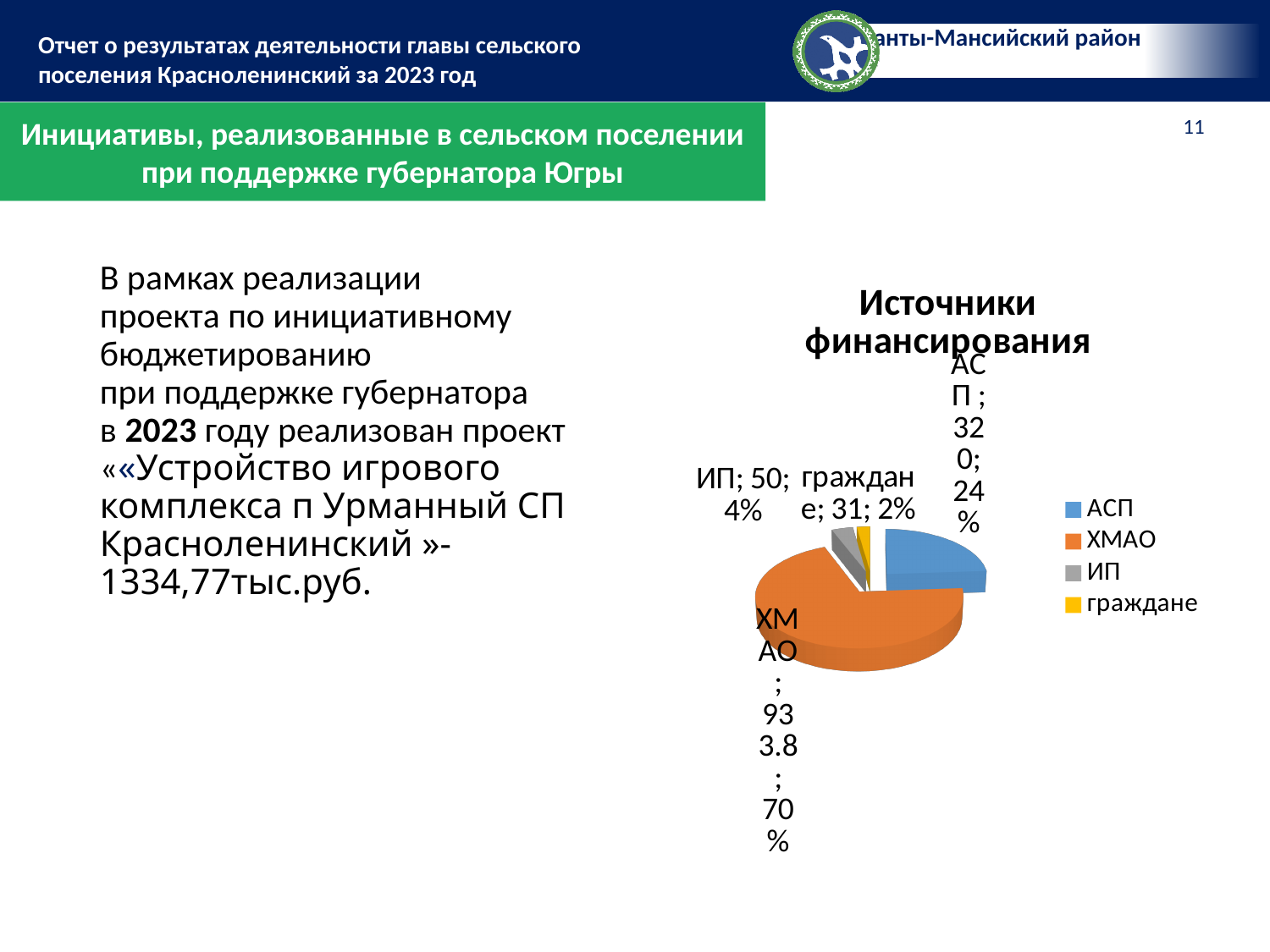
What is the chart's title? Источники финансирования What is the value for ИП in the pie chart? 50 What kind of chart is shown on the slide? pie chart What is the difference between the values for ХМАО and АСП? 613.8 Which category has the smallest slice of the pie? граждане What is the value for АСП in the pie chart? 320 Which category has the largest slice of the pie? ХМАО What share of the pie does ХМАО account for? 70% What is the value for граждане in the pie chart? 31 What is the value for ХМАО in the pie chart? 933.8 What share of the pie does АСП account for? 24% How many categories does the pie chart show? 4